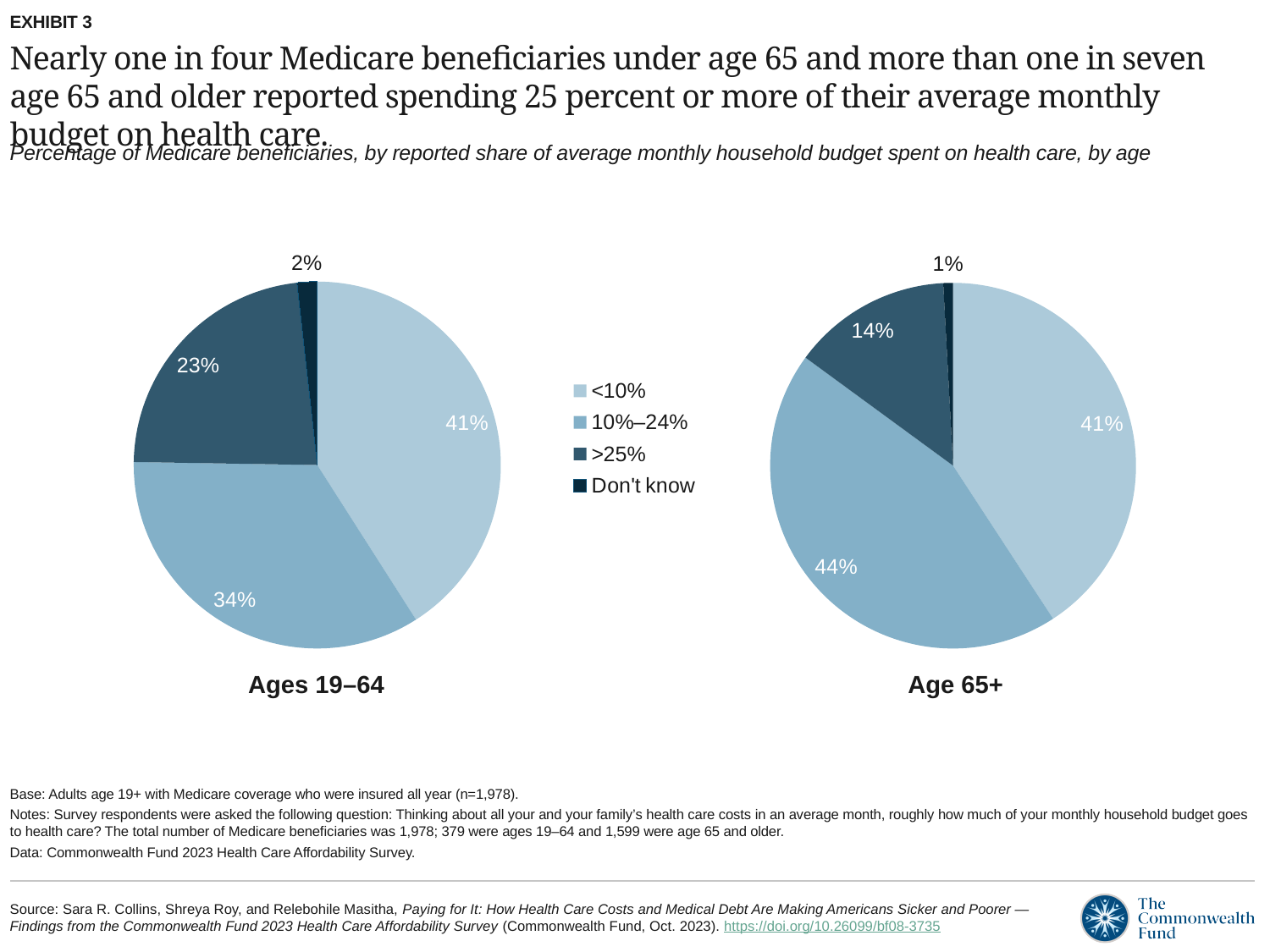
In the Ages 19–64 pie chart, which category has the largest share? <10% In the Ages 19–64 pie chart, what percentage of Medicare beneficiaries reported spending >25% of their budget on health care? 23% In the Age 65+ pie chart, which category has the smallest share? Don't know How many categories does the legend list? 4 Which age group has a larger share in the 10%–24% category, Ages 19–64 or Age 65+? Age 65+ What type of chart is used on this slide? Pie chart In the Age 65+ pie chart, what percentage of Medicare beneficiaries reported spending 10%–24% of their budget on health care? 44% What is the difference between the >25% share for Ages 19–64 and the >25% share for Age 65+? 9 percentage points What is the title of the Age 65+ pie chart? Age 65+ In the Ages 19–64 pie chart, what percentage answered 'Don't know'? 2% In the Ages 19–64 pie chart, what is the combined share of the 10%–24% and >25% categories? 57% In the Age 65+ pie chart, what percentage answered 'Don't know'? 1%